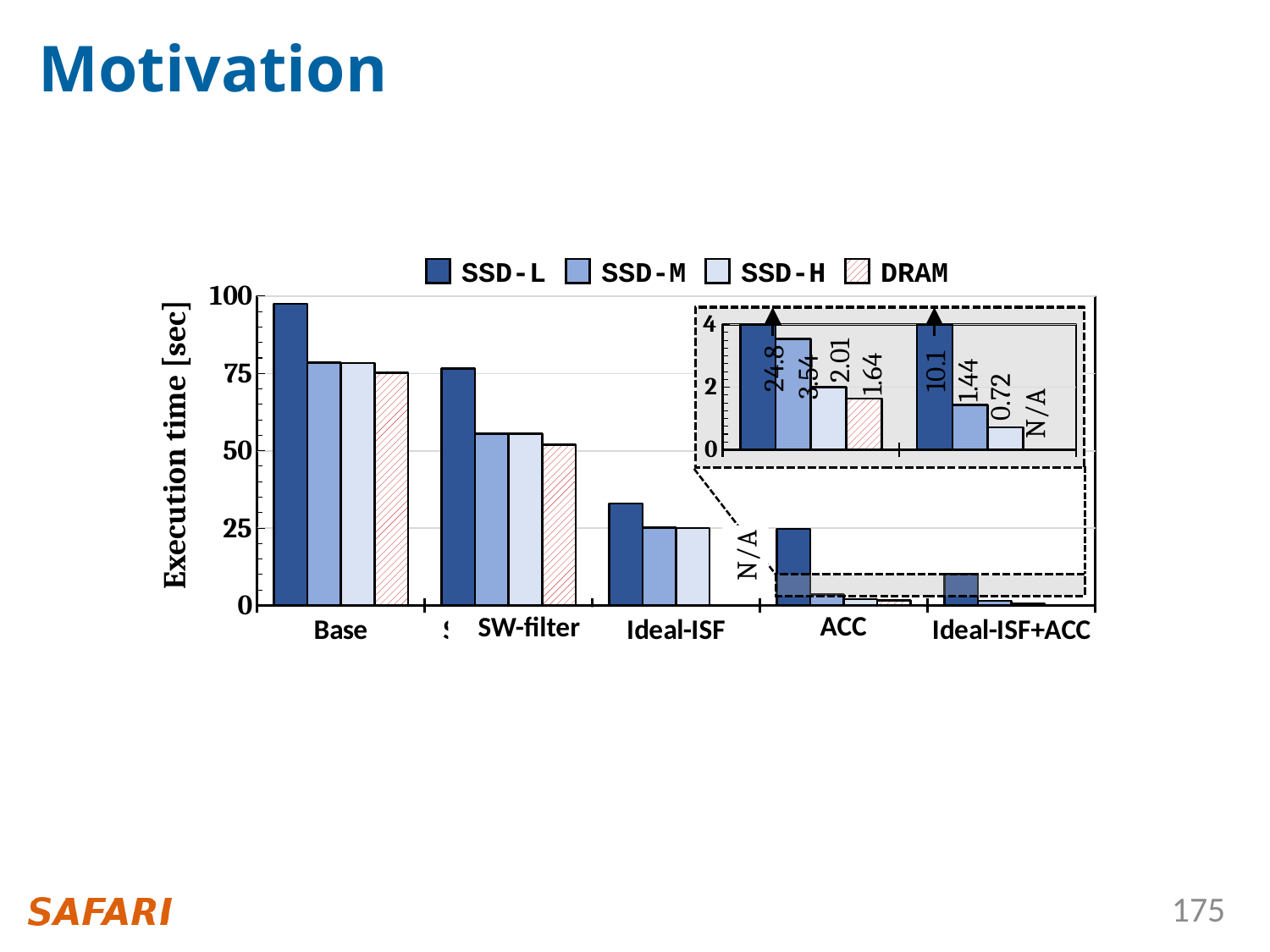
What is the execution time for SSD-M in the Ideal-ISF+ACC category? 1.44 What is the label of the y axis? Execution time [sec] What is the difference between the SSD-L and SSD-M values in the ACC category? 21.26 How many categories are shown along the x axis? 5 What is the execution time for SSD-L in the ACC category? 24.8 Does the SSD-L execution time rise or fall from Base to Ideal-ISF+ACC? fall What value is shown for DRAM in the Ideal-ISF+ACC category? N/A Is the SSD-L value for Base greater or less than 75? greater What kind of chart is shown on the slide? bar chart How many series does the legend list? 4 What is the execution time for SSD-H in the ACC category? 2.01 Which category has the highest SSD-L execution time? Base